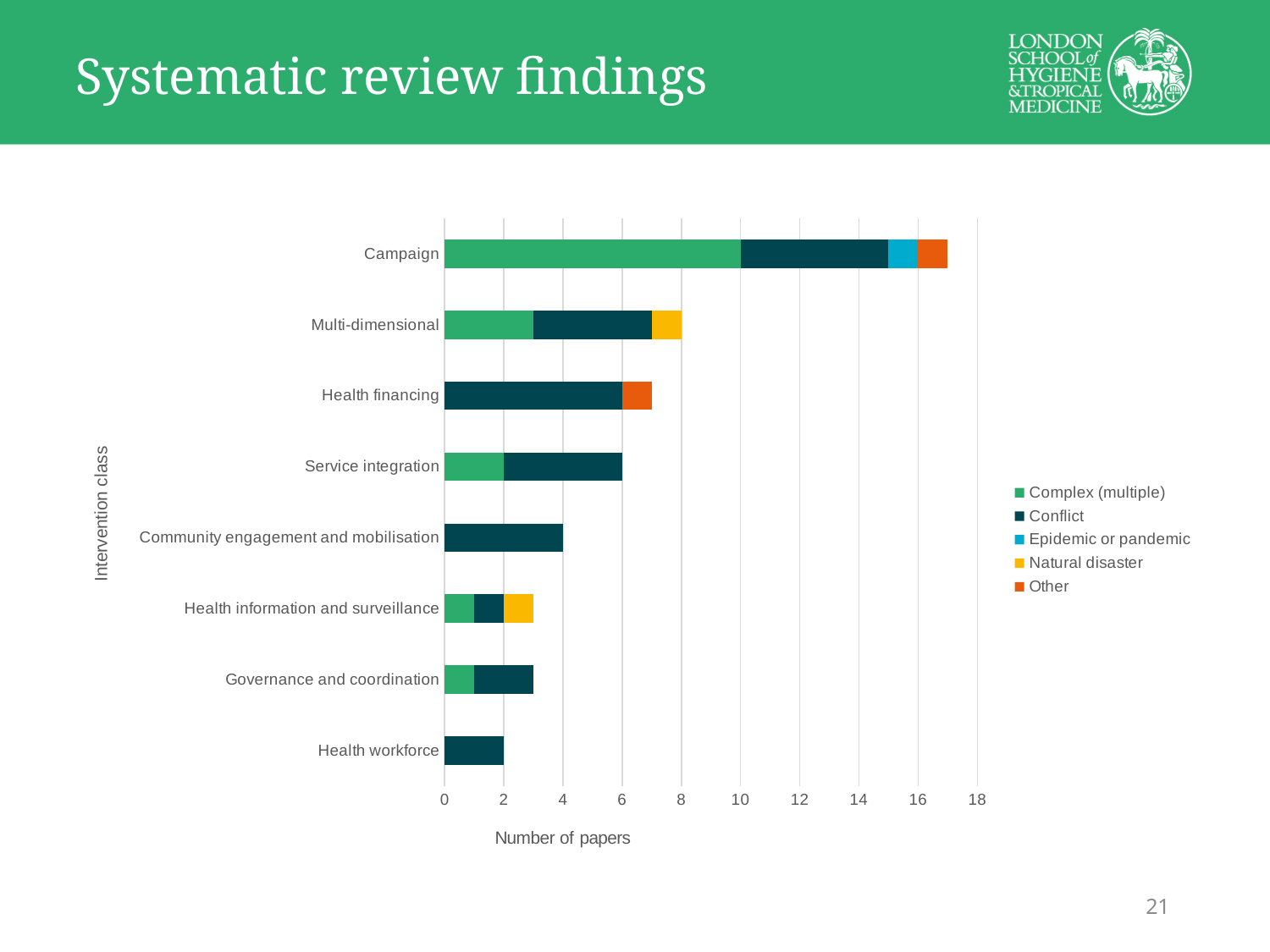
What is the number of papers for Community engagement and mobilisation? 4 What type of chart is shown on the slide? Bar chart How many intervention classes are plotted on the chart? 8 What is the total number of papers for Multi-dimensional? 8 Which intervention class has the lowest total number of papers? Health workforce Which intervention class has the highest total number of papers? Campaign What is the title of the horizontal axis? Number of papers Which has more papers in total, Service integration or Community engagement and mobilisation? Service integration What is the number of papers for Health workforce? 2 How many Complex (multiple) papers are there for Campaign? 10 Is the total number of papers for Campaign greater or less than 16? greater How many series does the legend list? 5